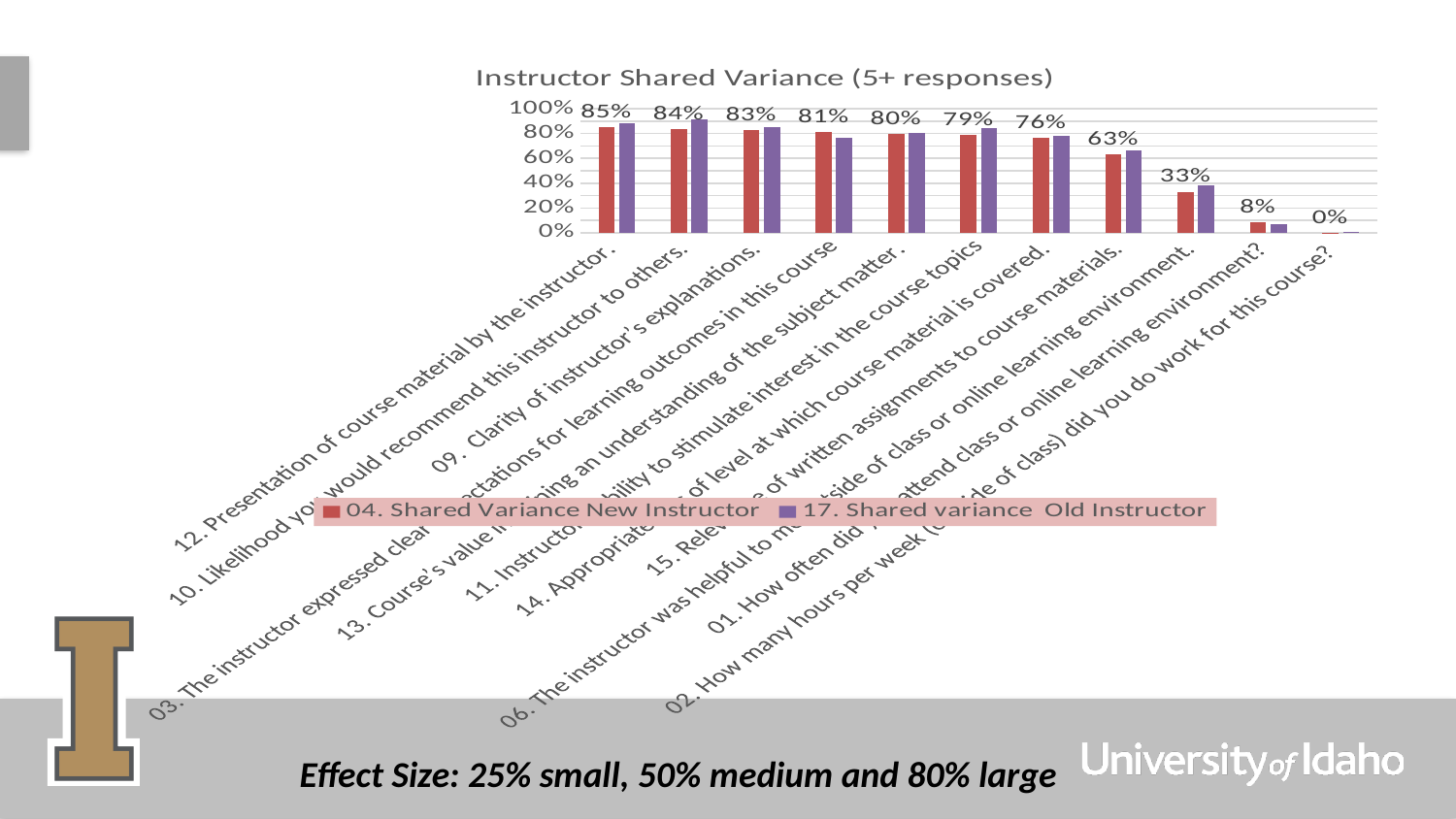
What is the Shared Variance New Instructor value for '15. Relevance of written assignments to course materials'? 63% Which category has the highest Shared Variance New Instructor value? 12. Presentation of course material by the instructor For '03. The instructor expressed clear expectations for learning outcomes in this course', which series has the larger value: Shared Variance New Instructor or Shared variance Old Instructor? 04. Shared Variance New Instructor What is the Shared Variance New Instructor value for '06. The instructor was helpful to me outside of class or online learning environment'? 33% What is the Shared Variance New Instructor value for '12. Presentation of course material by the instructor'? 85% Do the Shared Variance New Instructor values rise or fall from left to right along the x axis? fall What type of chart is shown on the slide? bar chart How many categories are plotted along the x axis? 11 Which category has the lowest Shared Variance New Instructor value? 02. How many hours per week (outside of class) did you do work for this course? How many series does the legend list? 2 What is the difference between the Shared Variance New Instructor values for '12. Presentation of course material by the instructor' and '15. Relevance of written assignments to course materials'? 22% What is the title of the chart? Instructor Shared Variance (5+ responses)